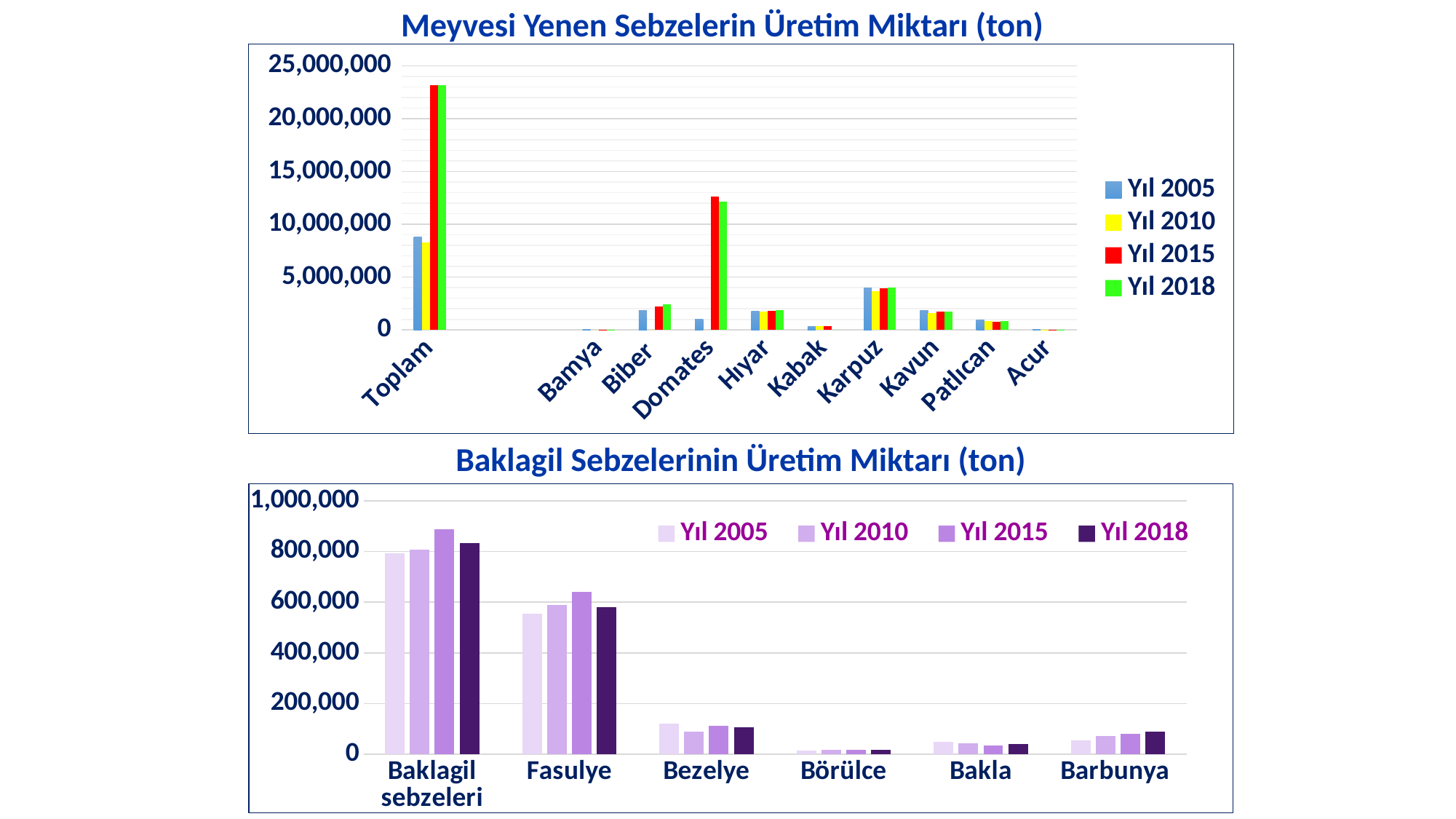
What kind of chart is the top chart, 'Meyvesi Yenen Sebzelerin Üretim Miktarı (ton)'? bar chart In the top chart 'Meyvesi Yenen Sebzelerin Üretim Miktarı (ton)', is the Yıl 2015 value for Toplam greater or less than 20,000,000? greater In the top chart 'Meyvesi Yenen Sebzelerin Üretim Miktarı (ton)', which has the larger Yıl 2018 value, Karpuz or Kavun? Karpuz In the top chart 'Meyvesi Yenen Sebzelerin Üretim Miktarı (ton)', how many series does the legend list? 4 In the bottom chart 'Baklagil Sebzelerinin Üretim Miktarı (ton)', is the Yıl 2015 value for Baklagil sebzeleri greater or less than 800,000? greater In the bottom chart 'Baklagil Sebzelerinin Üretim Miktarı (ton)', how many categories are shown on the x axis? 6 In the bottom chart 'Baklagil Sebzelerinin Üretim Miktarı (ton)', is the Yıl 2005 value for Fasulye greater or less than 600,000? less In the bottom chart 'Baklagil Sebzelerinin Üretim Miktarı (ton)', which has the larger Yıl 2018 value, Bezelye or Bakla? Bezelye In the top chart 'Meyvesi Yenen Sebzelerin Üretim Miktarı (ton)', how many categories are shown on the x axis? 10 In the bottom chart 'Baklagil Sebzelerinin Üretim Miktarı (ton)', which category has the lowest values? Börülce In the top chart 'Meyvesi Yenen Sebzelerin Üretim Miktarı (ton)', apart from Toplam, which category has the highest Yıl 2015 value? Domates